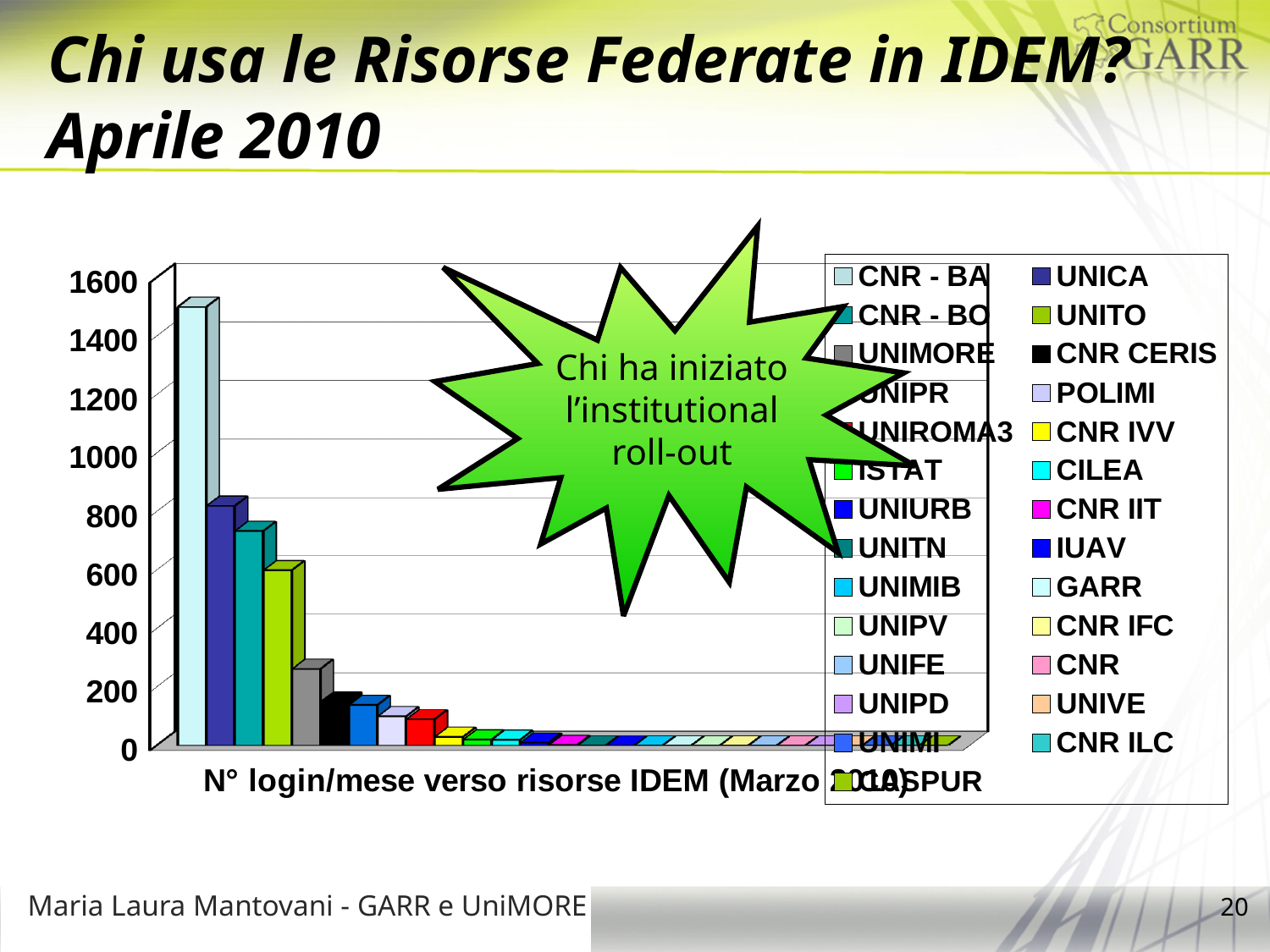
Is the value for UNIMORE greater or less than 400? less Which has a larger value, CNR - BA or UNICA? CNR - BA Which institution has the highest number of logins per month in the chart? CNR - BA Which has a larger value, UNITO or UNIMORE? UNITO Is the value for CNR - BA greater or less than 1400? greater Is the value for UNICA greater or less than 1000? less How many series does the legend list? 27 Do the bar values rise or fall from left to right across the chart? fall What kind of chart is shown on the slide? bar chart What is the label shown beneath the x axis of the chart? N° login/mese verso risorse IDEM (Marzo 2010)